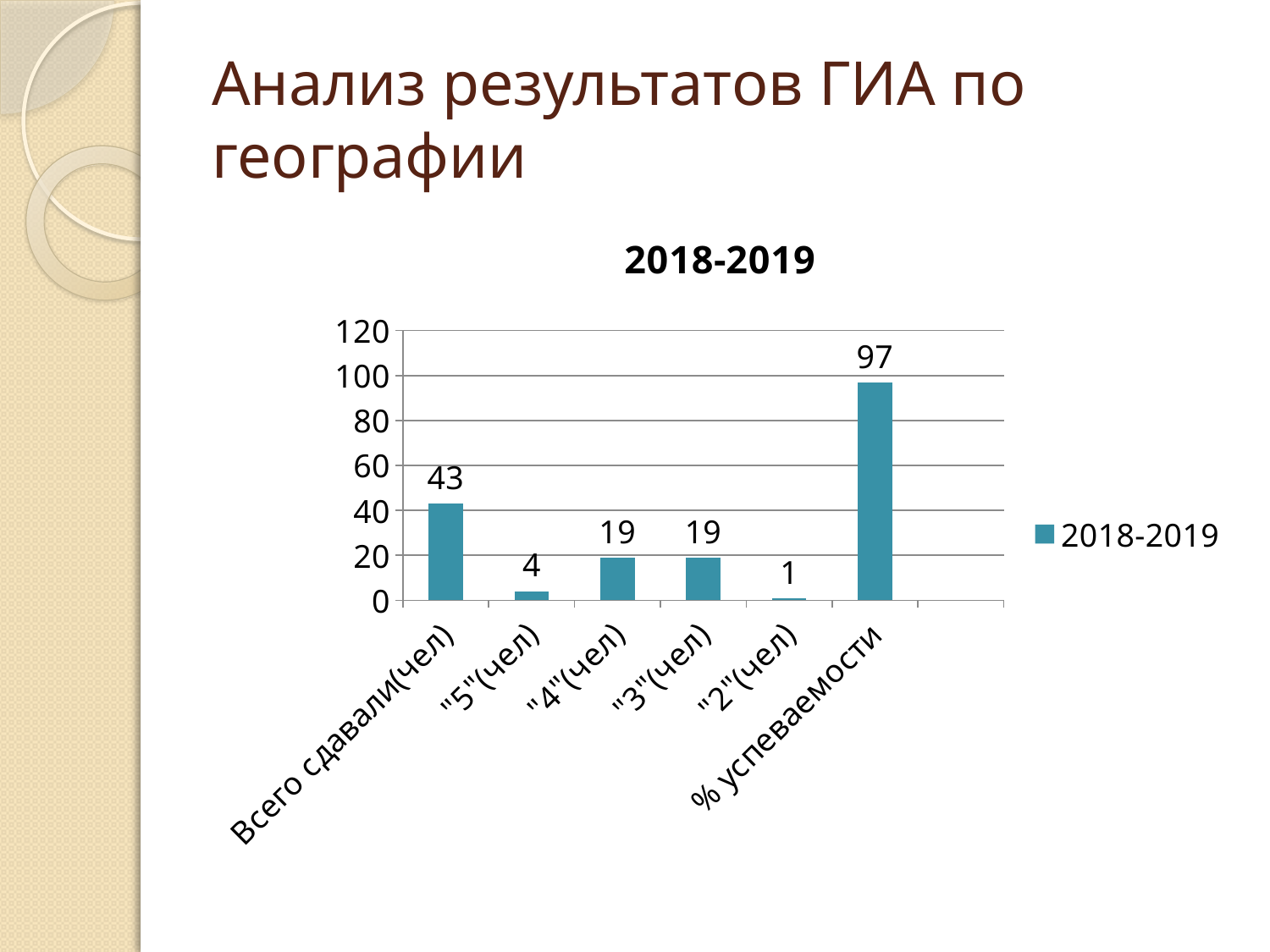
How many series does the legend list? 1 What is the value for "Всего сдавали(чел)"? 43 How many categories are shown on the x axis? 6 What is the difference between the values for "Всего сдавали(чел)" and ""4"(чел)"? 24 Which category has the lowest value? "2"(чел) Which category has the highest value? % успеваемости Which is larger, the value for ""5"(чел)" or the value for ""3"(чел)"? "3"(чел) What kind of chart is shown on the slide? bar chart What is the value for ""5"(чел)"? 4 What is the value for ""2"(чел)"? 1 What is the value for "% успеваемости"? 97 Is the value for "% успеваемости" greater or less than 80? greater